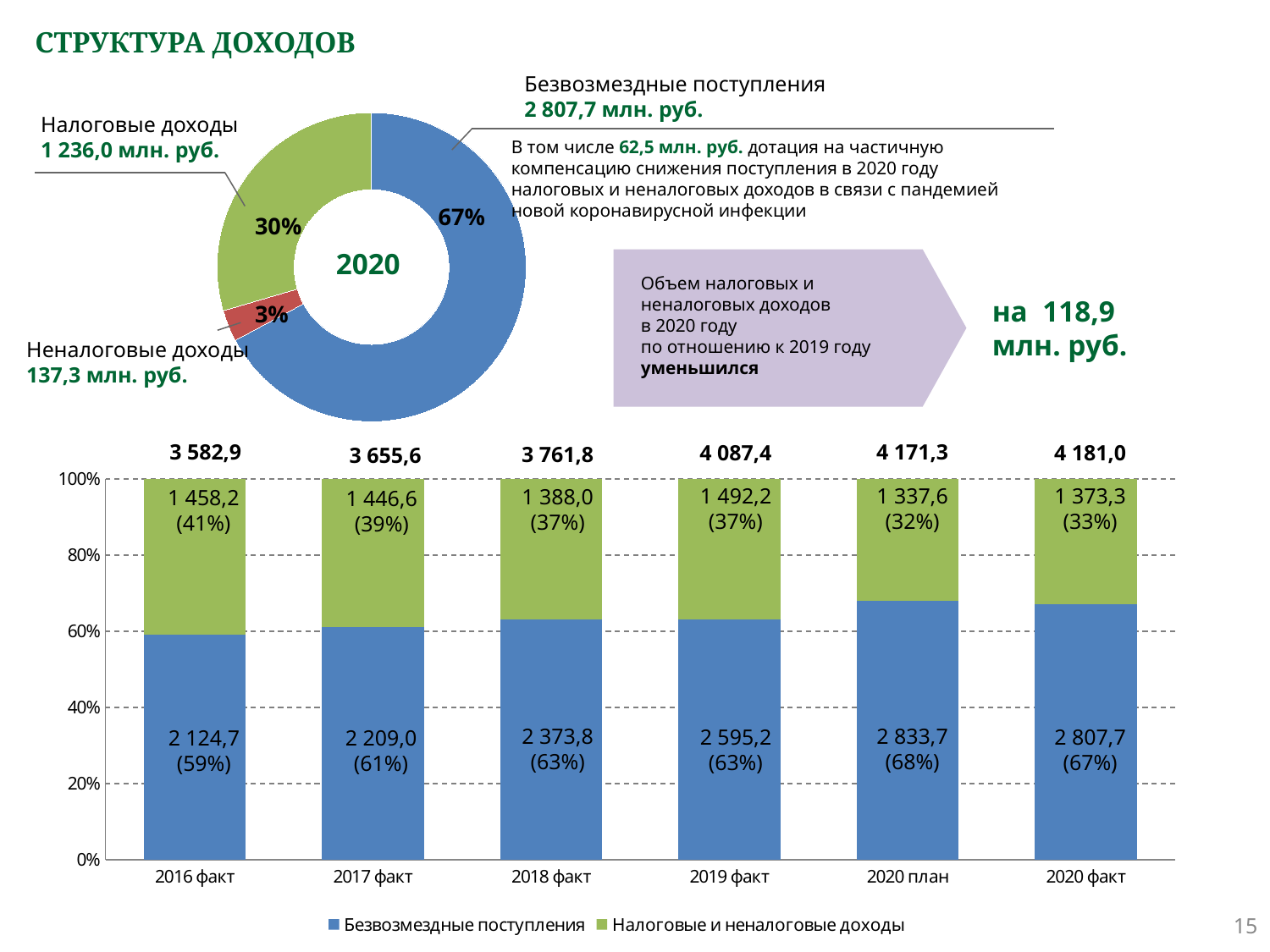
In the donut chart, which category has the smallest share? Неналоговые доходы In the donut chart, what share of 2020 income is Безвозмездные поступления? 67% In the stacked bar chart at the bottom, how many series does the legend list? 2 In the stacked bar chart at the bottom, what is the difference between the Безвозмездные поступления values for 2020 план and 2020 факт? 26,0 In the donut chart, how many segments are shown? 3 In the donut chart, what is the value shown for Налоговые доходы? 1 236,0 млн. руб. In the stacked bar chart at the bottom, which year has the highest total? 2020 факт In the stacked bar chart at the bottom, what is the value of Безвозмездные поступления for 2018 факт? 2 373,8 In the stacked bar chart at the bottom, how many bars are there? 6 In the stacked bar chart at the bottom, what percentage does Налоговые и неналоговые доходы make up in 2020 план? 32% In the stacked bar chart at the bottom, what is the total shown above the 2019 факт bar? 4 087,4 What type of chart is shown at the bottom of the slide? Stacked bar chart